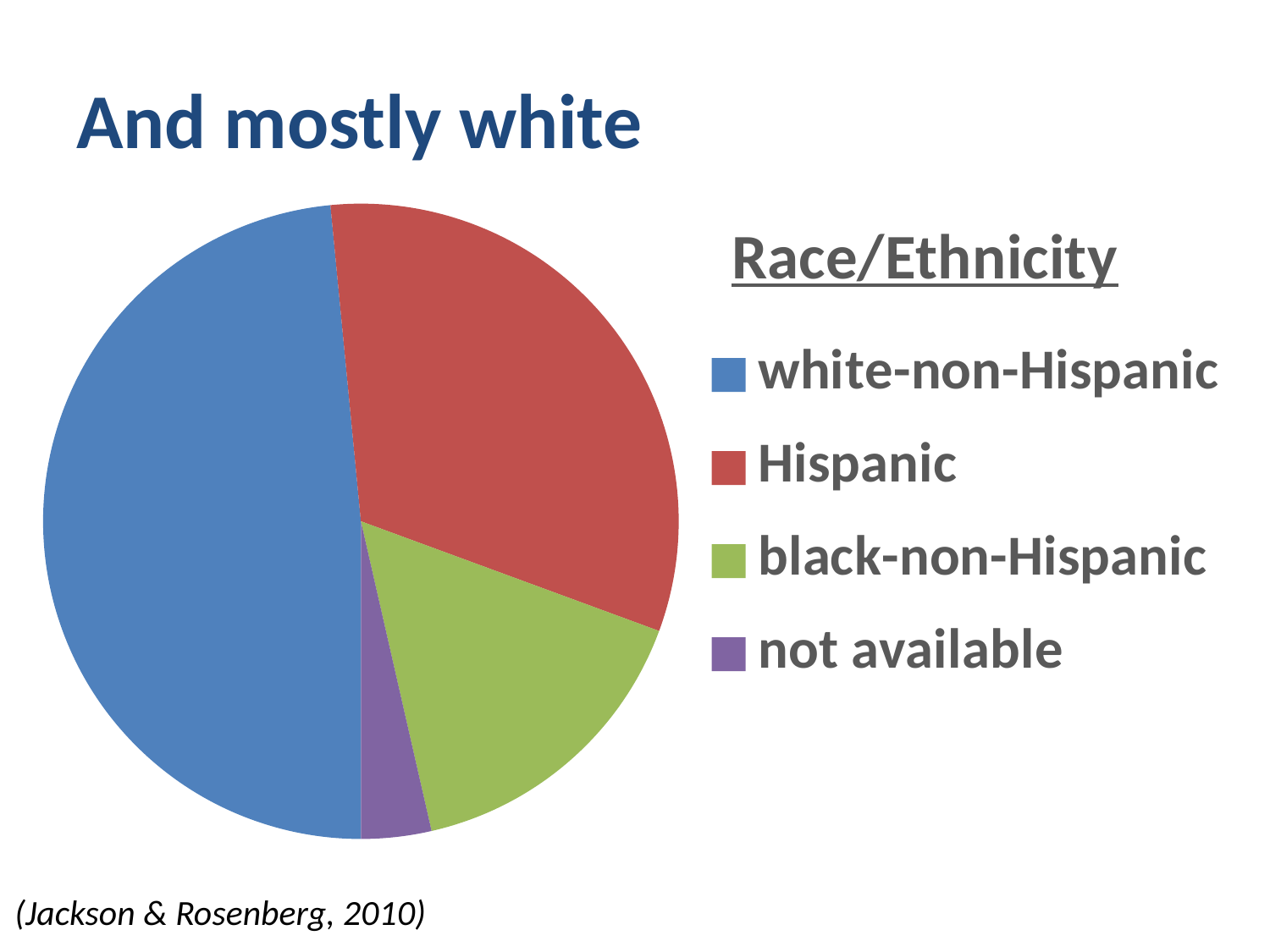
Which category is the second largest slice of the pie chart? Hispanic How many slices does the pie chart have? 4 Which slice is larger, white-non-Hispanic or Hispanic? white-non-Hispanic Which category has the smallest slice of the pie chart? not available What heading is shown above the legend of the pie chart? Race/Ethnicity What kind of chart is shown on the slide? pie chart Which slice is larger, Hispanic or black-non-Hispanic? Hispanic Which slice is larger, black-non-Hispanic or not available? black-non-Hispanic What colour is the slice for black-non-Hispanic? green Which category has the largest slice of the pie chart? white-non-Hispanic